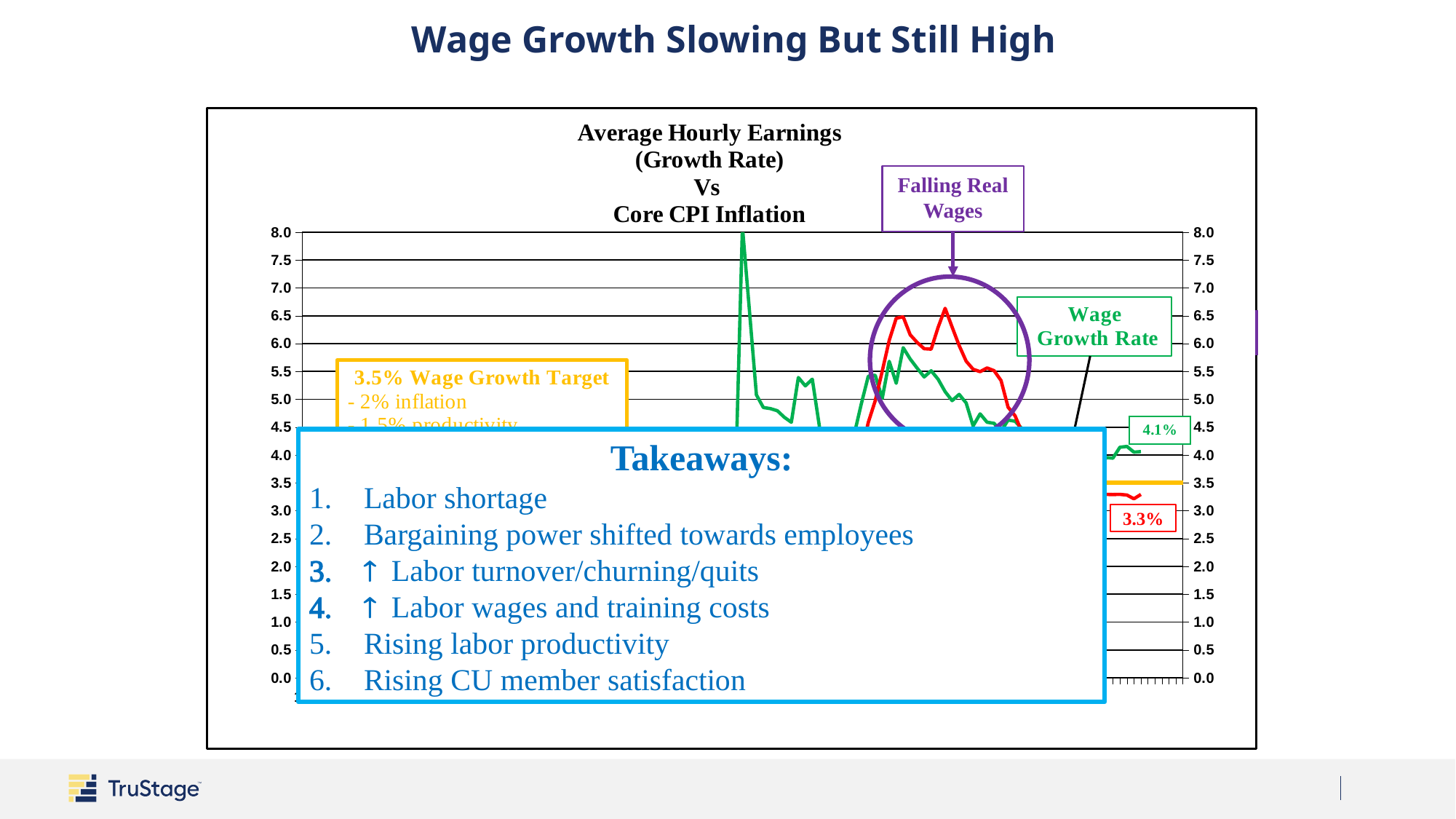
What is the latest labeled value of the Wage Growth Rate (green line)? 4.1% What is the maximum value shown on the chart's vertical axis? 8.0 What is the difference between the latest labeled Wage Growth Rate (4.1%) and the latest labeled Core CPI Inflation (3.3%)? 0.8 percentage points What wage growth target is marked by the yellow line on the chart? 3.5% Is the latest labeled Wage Growth Rate greater or less than the 3.5% wage growth target? greater What is the title of the chart? Average Hourly Earnings (Growth Rate) Vs Core CPI Inflation What is the latest labeled value of the red Core CPI Inflation line? 3.3% Is the peak of the green Wage Growth Rate line greater or less than 7.5? greater Which is larger at the latest labeled point: the Wage Growth Rate or Core CPI Inflation? Wage Growth Rate What kind of chart is shown on the slide? line chart How many data series are plotted on the chart? 3 Is the peak of the red Core CPI Inflation line inside the purple circle greater or less than 6.0? greater